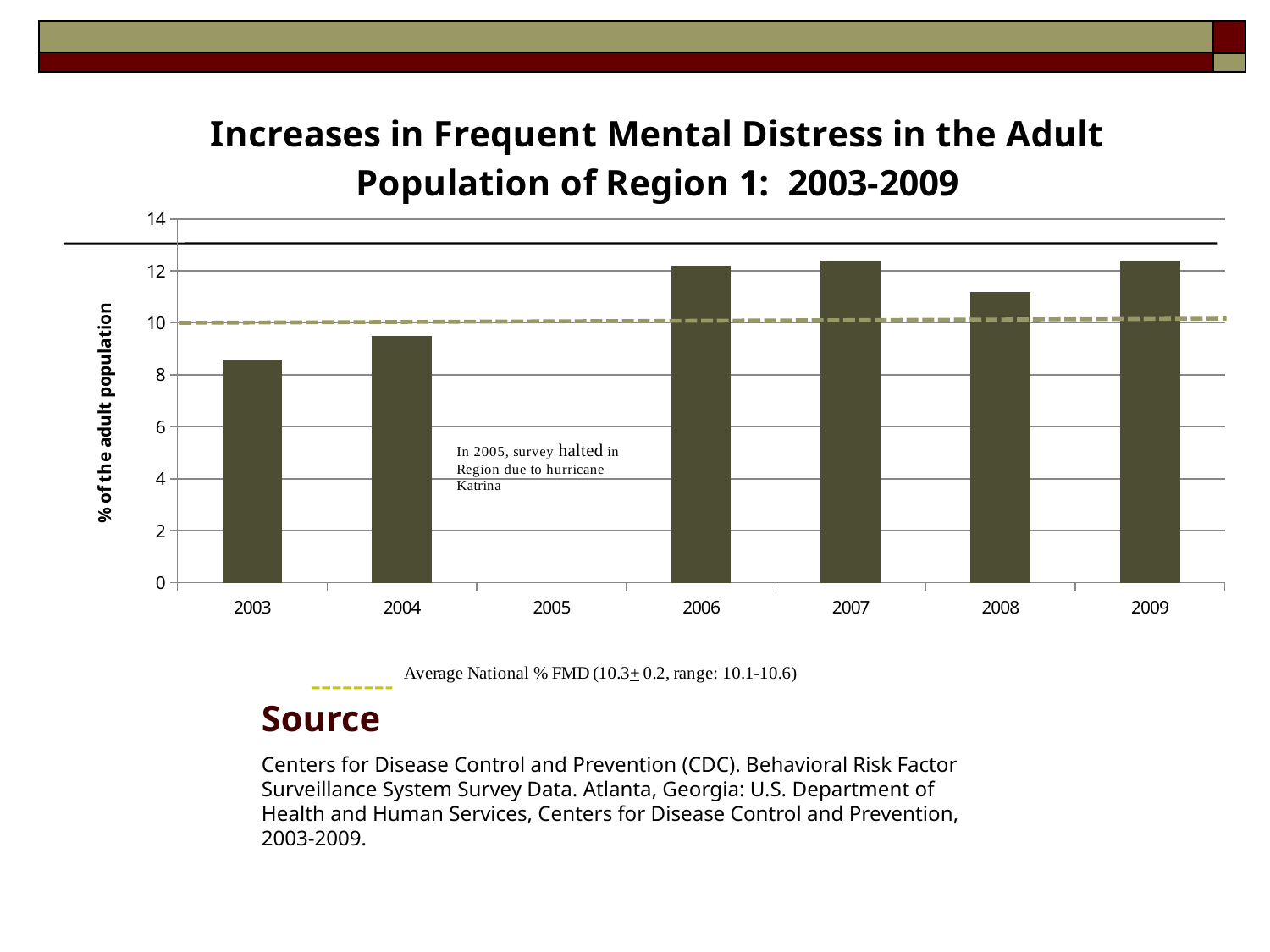
Is the value for 2008 greater or less than 12? less Which is larger, the value for 2007 or the value for 2008? 2007 Is the value for 2004 greater or less than 10? less How many bars are plotted on the chart? 6 Which is larger, the value for 2003 or the value for 2006? 2006 What is the title of the chart? Increases in Frequent Mental Distress in the Adult Population of Region 1: 2003-2009 Which year has the lowest bar on the chart? 2003 What does the dashed horizontal line on the chart represent? Average National % FMD Is the value for 2003 greater or less than 10? less Which year has no bar plotted on the chart? 2005 What kind of chart is shown on the slide? bar chart